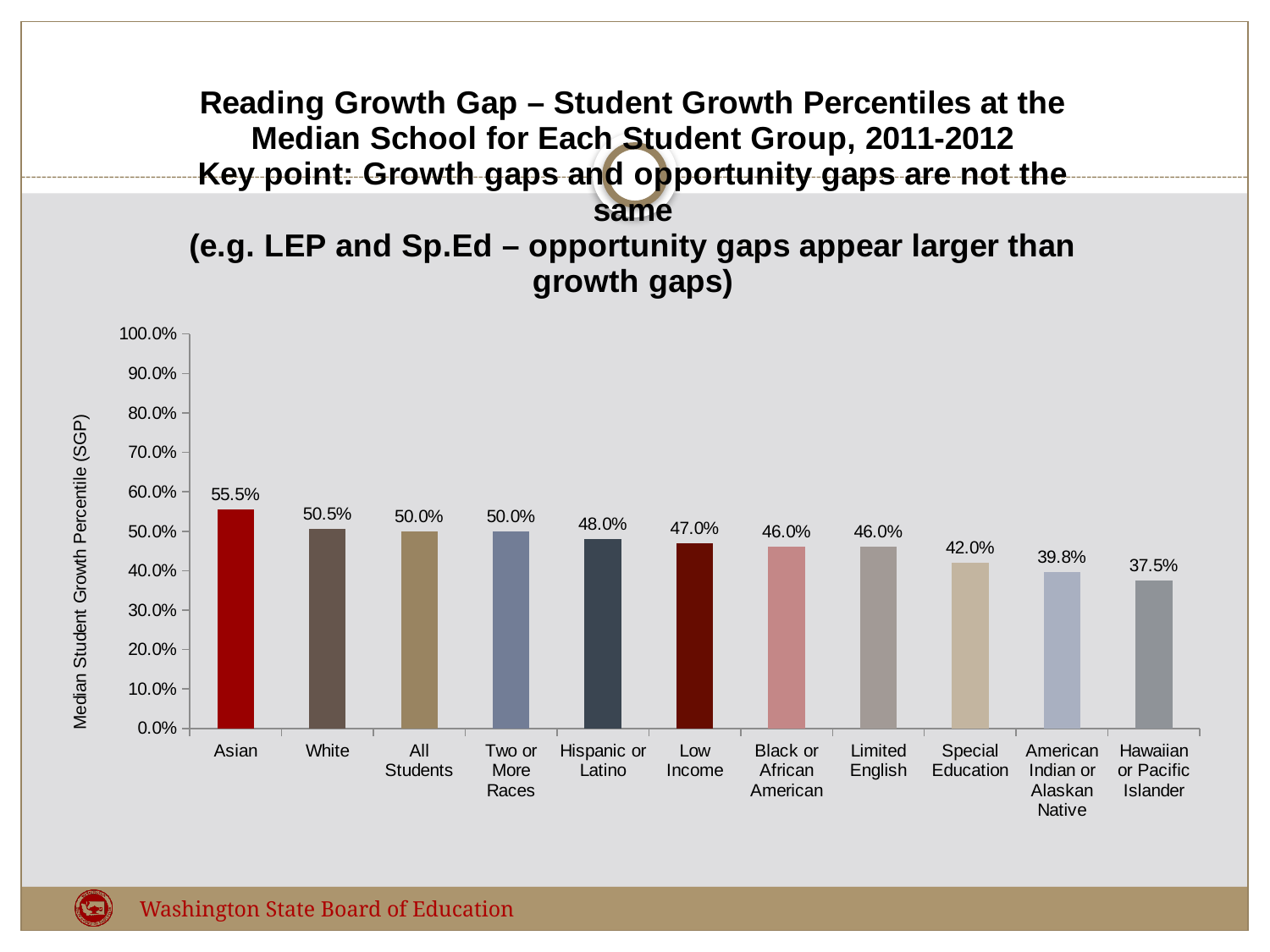
Which student group has the lowest median student growth percentile? Hawaiian or Pacific Islander Which is larger, the value for Hispanic or Latino or the value for American Indian or Alaskan Native? Hispanic or Latino What is the difference between the values for Asian and Hawaiian or Pacific Islander? 18.0% What is the value shown for Hawaiian or Pacific Islander? 37.5% Do the values generally rise or fall from left to right along the x axis? Fall What is the label of the y axis? Median Student Growth Percentile (SGP) Which student group has the highest median student growth percentile? Asian What is the median student growth percentile for Asian students? 55.5% What kind of chart is shown on the slide? Bar chart How many student groups are shown on the x axis? 11 What is the value shown for Special Education? 42.0% What is the difference between the values for White and Low Income? 3.5%